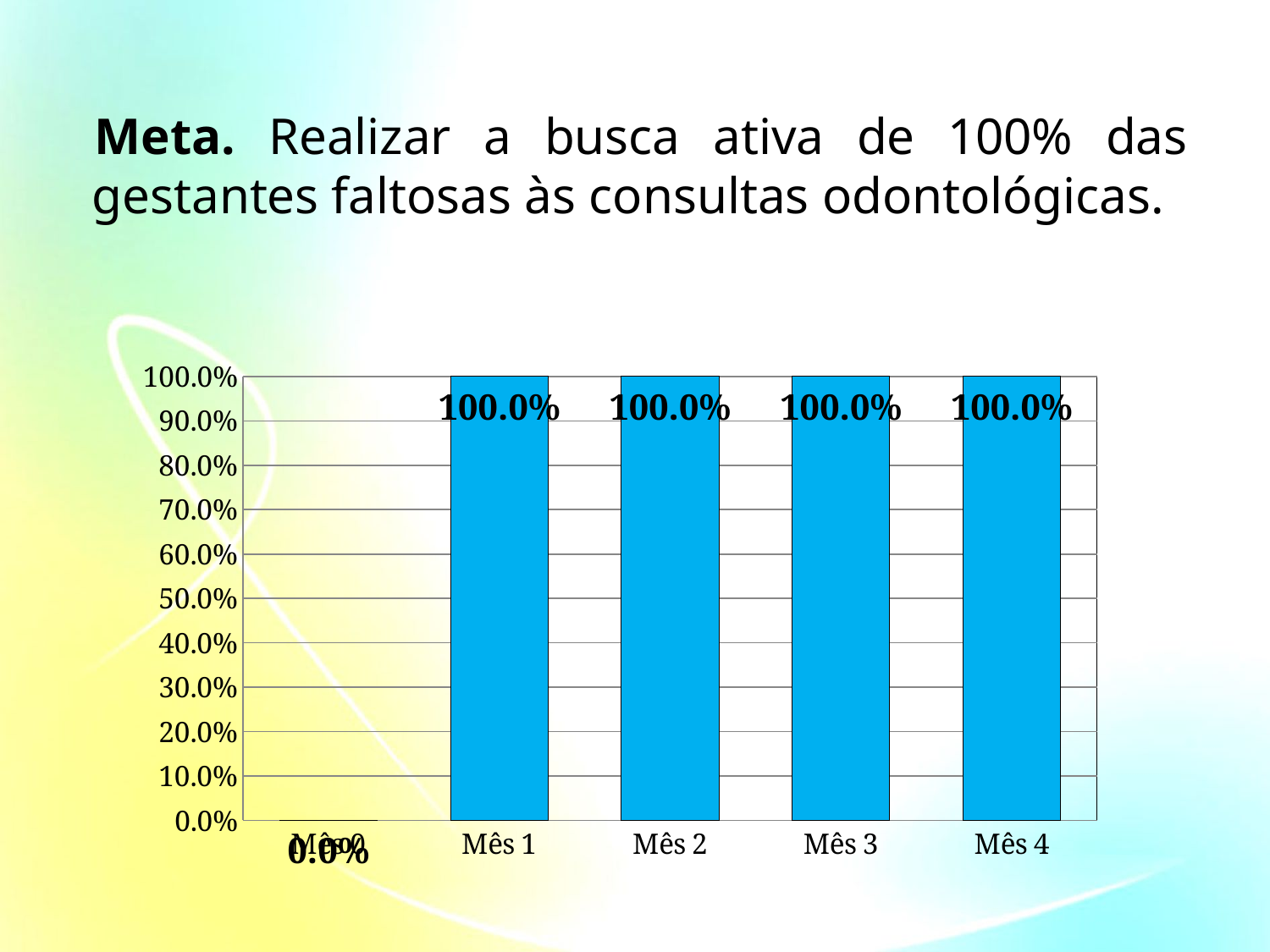
What is the difference between the value for Mês 2 and the value for the leftmost category? 100.0% Which is larger, the value for Mês 4 or the value for the leftmost category? Mês 4 What colour are the bars in the chart? Blue What kind of chart is shown on the slide? Bar chart Does the value rise or fall from the leftmost category to Mês 1? Rise What is the value for Mês 1? 100.0% Is the value for Mês 3 greater or less than 50.0%? greater What is the highest tick value shown on the y axis? 100.0% Which category has the lowest value? The leftmost category (Mês 0) What is the value for the leftmost category in the chart? 0.0% How many categories are shown on the x axis? 5 What is the value for Mês 3? 100.0%